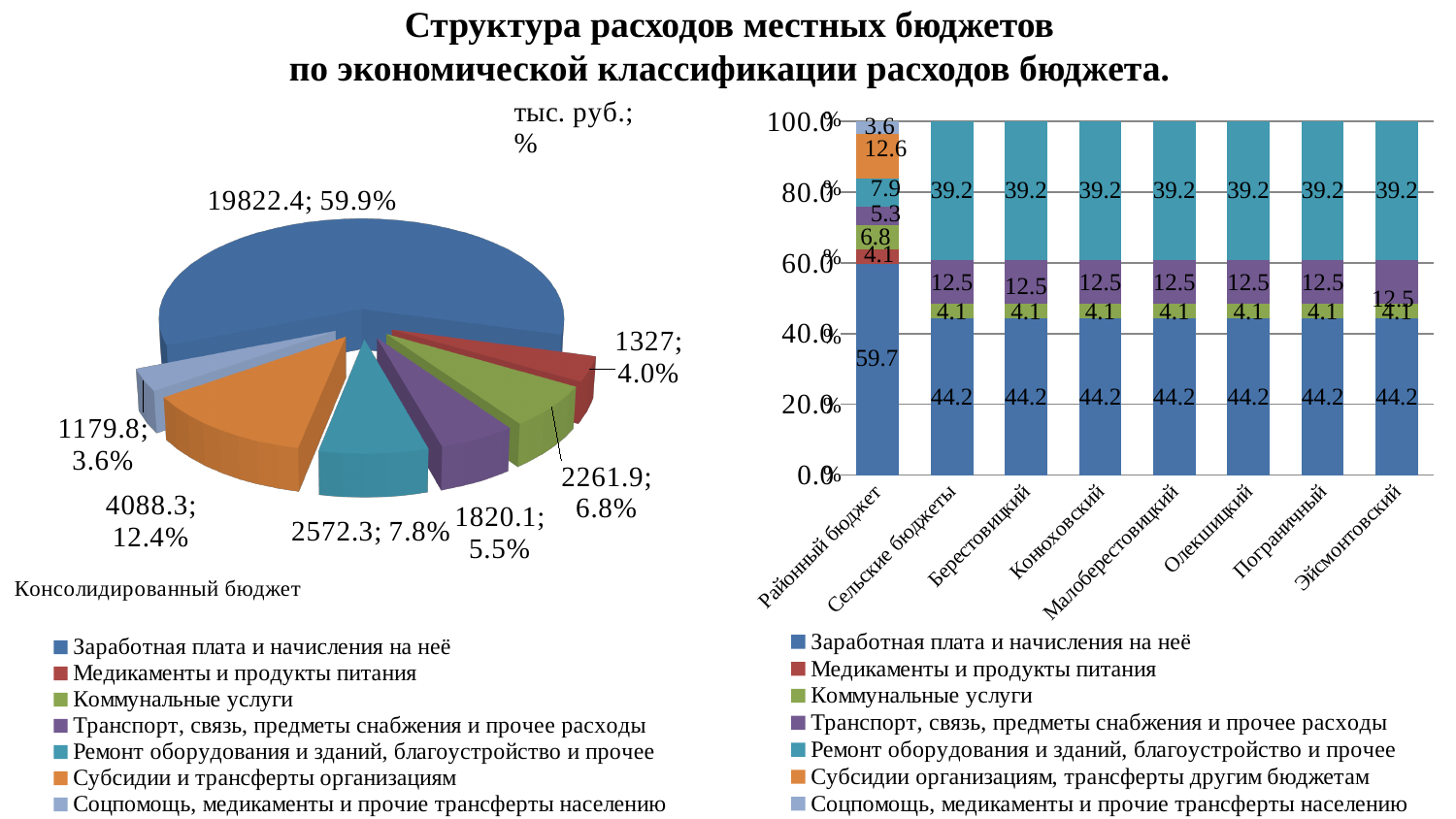
In the pie chart on the left, which is larger: the slice for Ремонт оборудования и зданий, благоустройство и прочее or the slice for Транспорт, связь, предметы снабжения и прочее расходы? Ремонт оборудования и зданий, благоустройство и прочее In the pie chart on the left, which category has the smallest slice? Соцпомощь, медикаменты и прочие трансферты населению In the stacked bar chart on the right, what is the value of the Субсидии организациям, трансферты другим бюджетам segment for Районный бюджет? 12.6 In the pie chart on the left, what is the value labelled for Коммунальные услуги? 2261.9 How many categories are shown on the x axis of the stacked bar chart on the right? 8 In the pie chart on the left, what value and share are shown for the largest slice (Заработная плата и начисления на неё)? 19822.4; 59.9% In the pie chart on the left, what share does the slice for Субсидии и трансферты организациям have? 12.4% What type of chart is the chart on the left of the slide? Pie chart In the stacked bar chart on the right, what is the value of the Заработная плата и начисления на неё segment for Районный бюджет? 59.7 How many series does the legend of the stacked bar chart on the right list? 7 In the stacked bar chart on the right, what is the value of the Ремонт оборудования и зданий, благоустройство и прочее segment for Берестовицкий? 39.2 In the pie chart on the left, what is the difference between the value for Субсидии и трансферты организациям and the value for Медикаменты и продукты питания? 2761.3